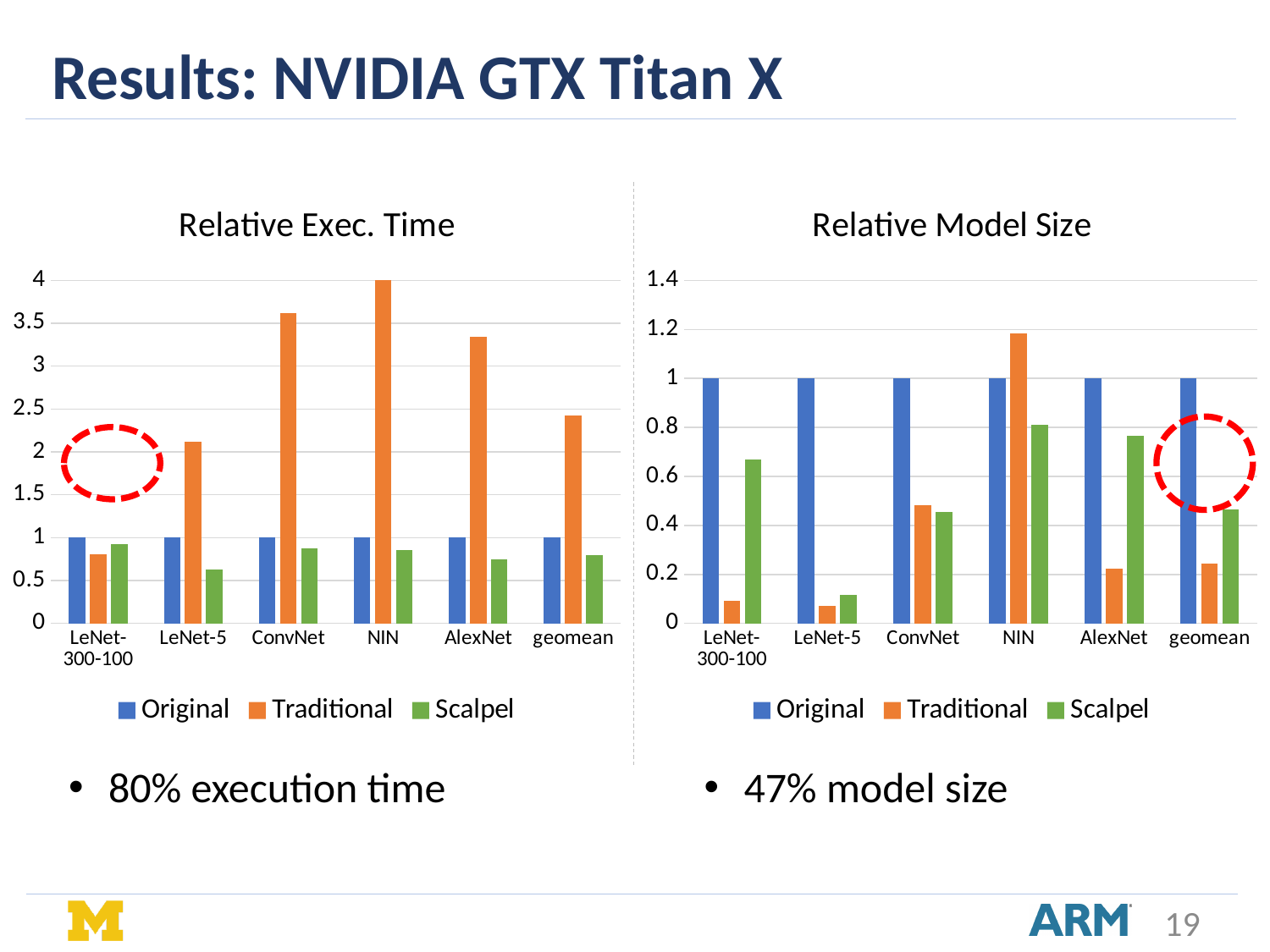
How many categories are shown on the x axis of the Relative Exec. Time chart? 6 In the Relative Model Size chart, which is larger for geomean, the Traditional value or the Scalpel value? Scalpel In the Relative Model Size chart, is the Traditional value for AlexNet greater or less than 0.4? less In the Relative Exec. Time chart, is the Traditional value for geomean greater or less than 2? greater In the Relative Exec. Time chart, what is the value of the Original series for NIN? 1 In the Relative Model Size chart, which category has the lowest Scalpel value? LeNet-5 In the Relative Exec. Time chart, which category has the highest Traditional value? NIN In the Relative Exec. Time chart, which category has the lowest Scalpel value? LeNet-5 How many series does the legend of the Relative Model Size chart list? 3 In the Relative Model Size chart, which category has the highest Traditional value? NIN In the Relative Exec. Time chart, is the Traditional value for AlexNet greater or less than 3? greater What kind of chart is the Relative Exec. Time chart? bar chart